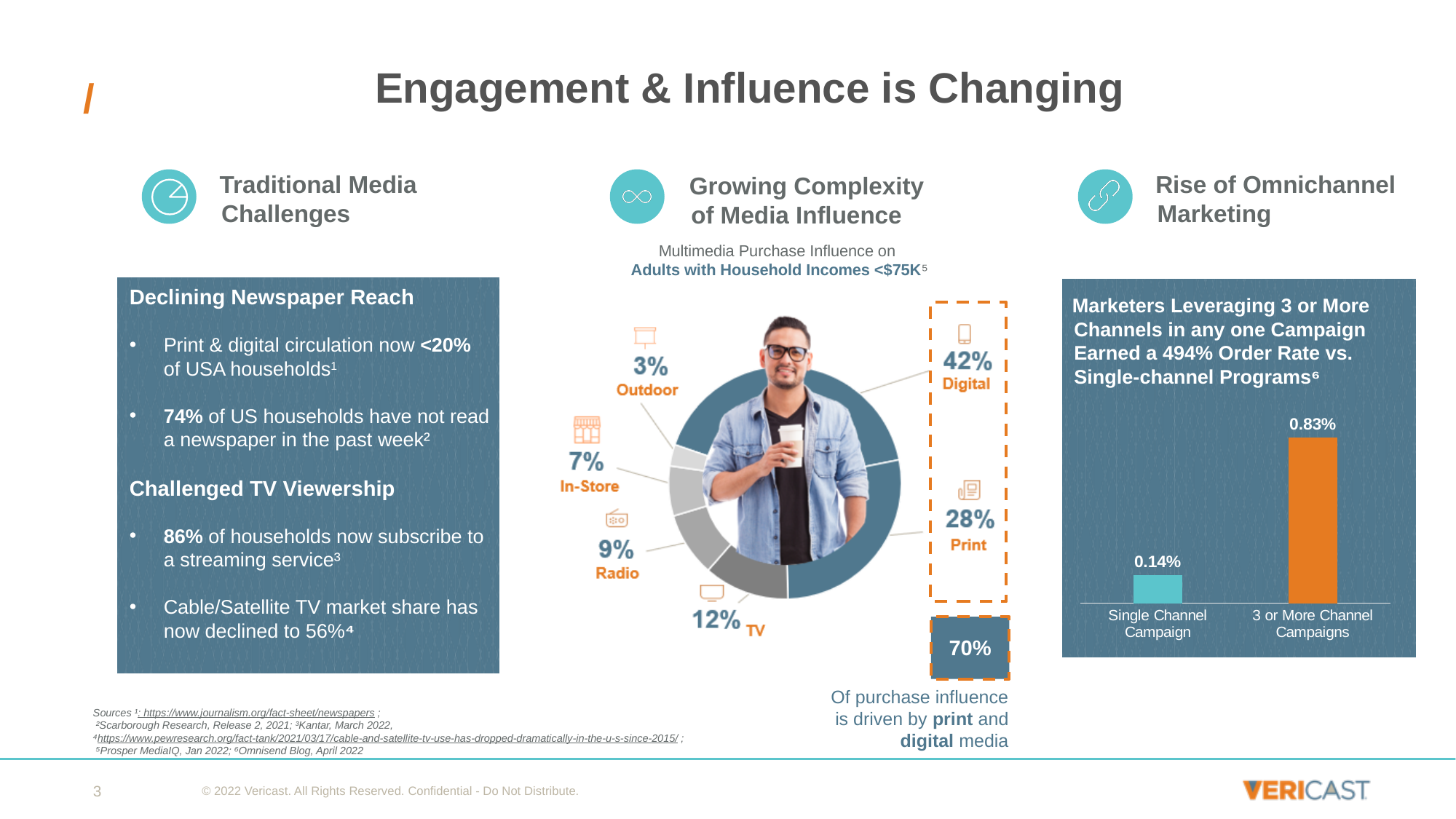
In the Multimedia Purchase Influence pie chart, how much larger is the Digital share than the Print share? 14% In the Multimedia Purchase Influence pie chart, which media category has the smallest share? Outdoor In the Multimedia Purchase Influence pie chart, which has a larger share, Radio or TV? TV In the Multimedia Purchase Influence pie chart, what share is attributed to Digital? 42% In the Multimedia Purchase Influence pie chart, which media category has the largest share? Digital In the Marketers Leveraging 3 or More Channels chart on the right, what is the value for Single Channel Campaign? 0.14% In the Multimedia Purchase Influence pie chart, what share is attributed to Print? 28% How many media categories are shown in the Multimedia Purchase Influence pie chart? 6 In the Marketers Leveraging 3 or More Channels chart on the right, what is the difference between the 3 or More Channel Campaigns value and the Single Channel Campaign value? 0.69% In the Marketers Leveraging 3 or More Channels chart on the right, what is the value for 3 or More Channel Campaigns? 0.83% In the Multimedia Purchase Influence pie chart, what is the combined share of Print and Digital? 70% What kind of chart is used for the Multimedia Purchase Influence data in the middle of the slide? Pie chart